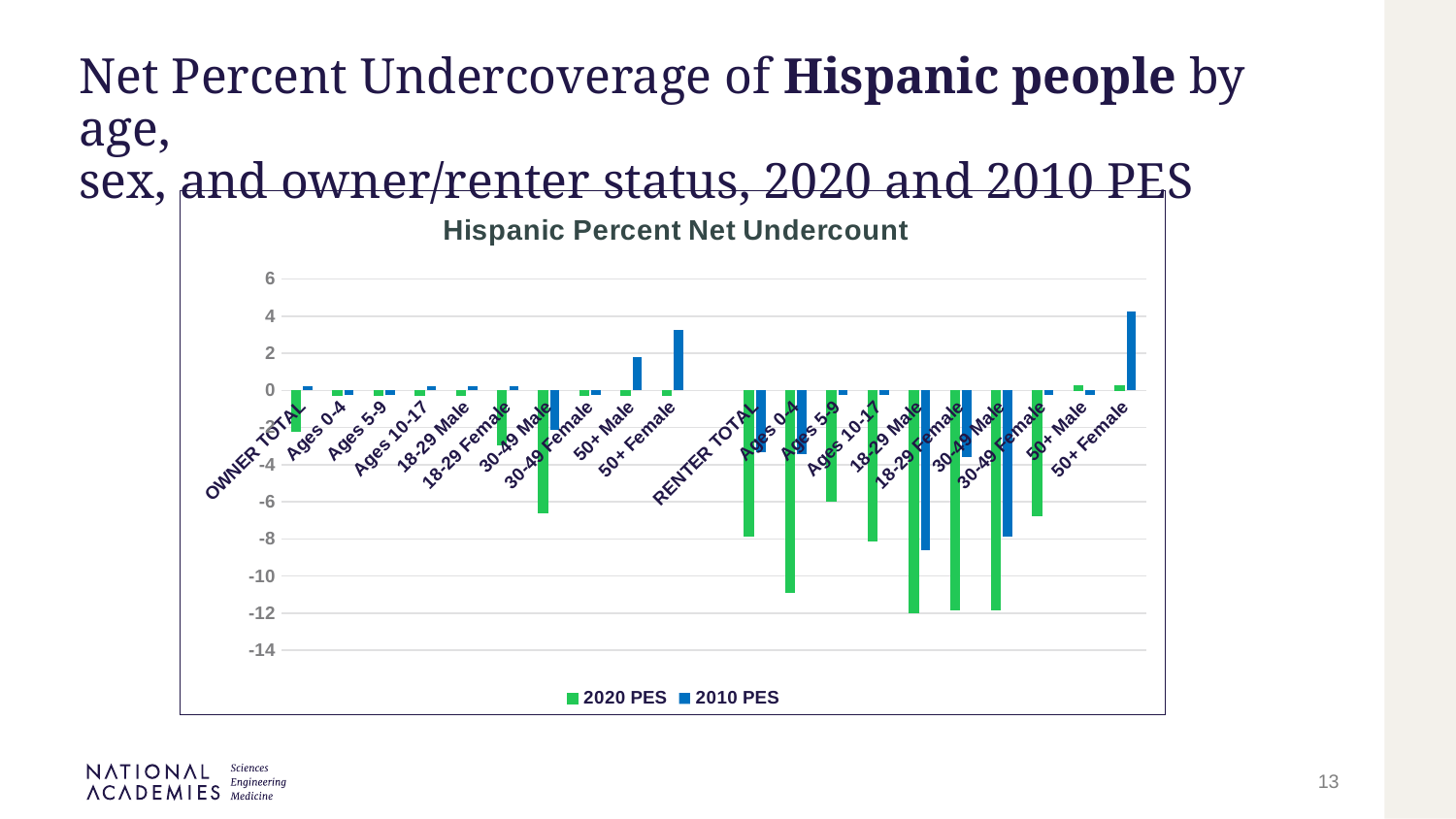
What is the title of the chart? Hispanic Percent Net Undercount How many categories are shown along the x axis of the chart? 20 Is the 2020 PES value for the renter Ages 0-4 category greater or less than -10? less Is the 2010 PES value for the owner 50+ Female category greater or less than 2? greater Is the 2020 PES value for the renter 18-29 Male category greater or less than -10? less What kind of chart is shown on the slide? bar chart Which is larger, the 2010 PES value for owner 50+ Male or for owner 50+ Female? Owner 50+ Female Which category has the highest 2010 PES value in the chart? Renter 50+ Female How many series does the legend of the chart list? 2 What are the two series named in the chart legend? 2020 PES and 2010 PES